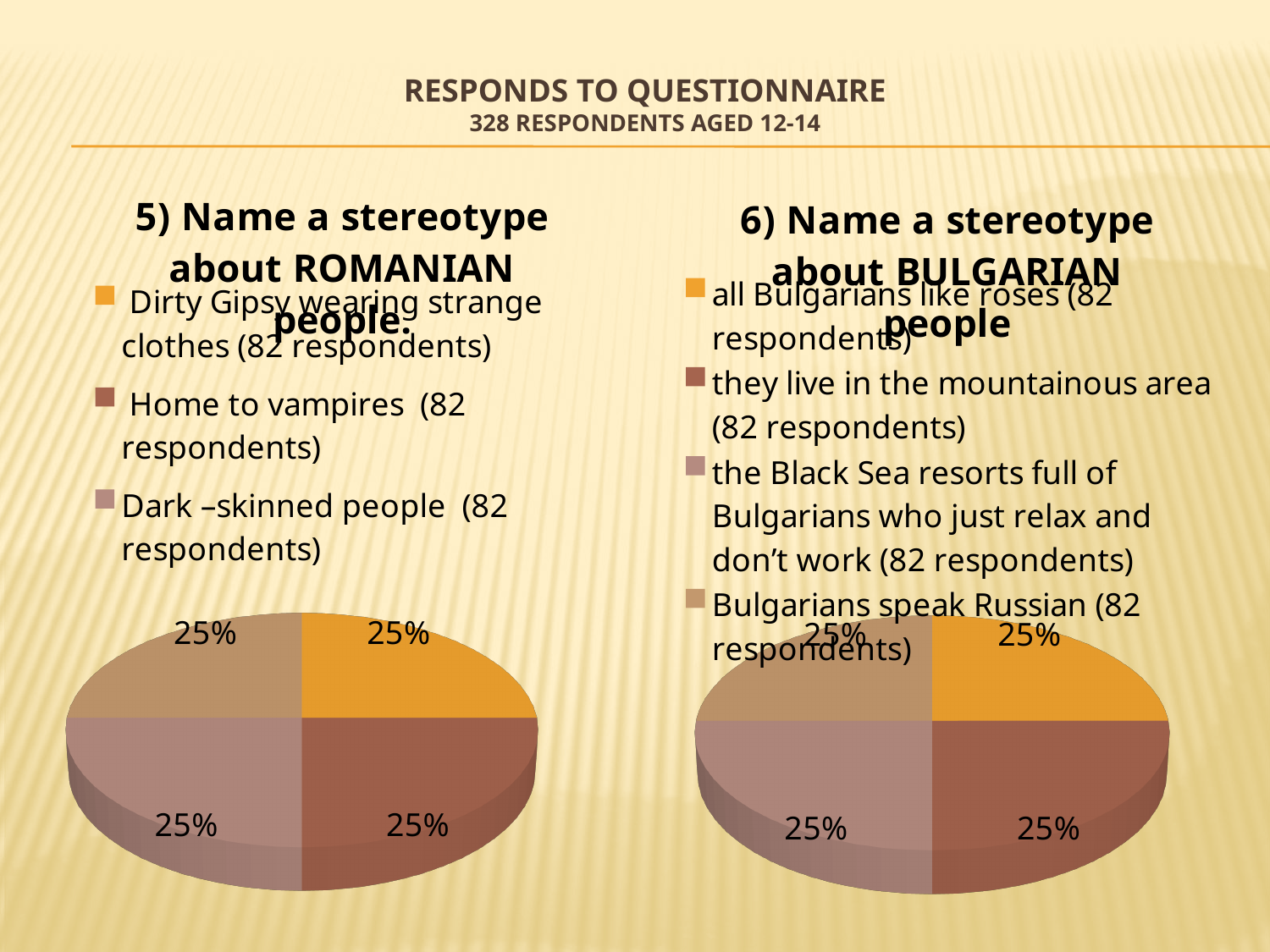
How many slices does the pie chart under question 5 (Romanian people) have? 4 How many slices does the pie chart under question 6 (Bulgarian people) have? 4 In the pie chart under question 6 (Bulgarian people), is the share for 'they live in the mountainous area' larger or smaller than the share for 'the Black Sea resorts full of Bulgarians who just relax and don't work', or are they equal? equal What kind of chart is shown under question 5 about Romanian people? pie chart In the pie chart under question 6 (Bulgarian people), what share is labelled on the slice for 'Bulgarians speak Russian'? 25% In the pie chart under question 5 (Romanian people), what share is labelled on the slice for 'Home to vampires'? 25% How many legend entries are listed for the chart under question 6 (Bulgarian people)? 4 What is the total number of respondents stated in the slide title? 328 How many respondents are stated for each stereotype in the legend of the chart under question 6 (Bulgarian people)? 82 respondents What kind of chart is shown under question 6 about Bulgarian people? pie chart In the pie chart under question 6 (Bulgarian people), what share is labelled on the slice for 'all Bulgarians like roses'? 25%